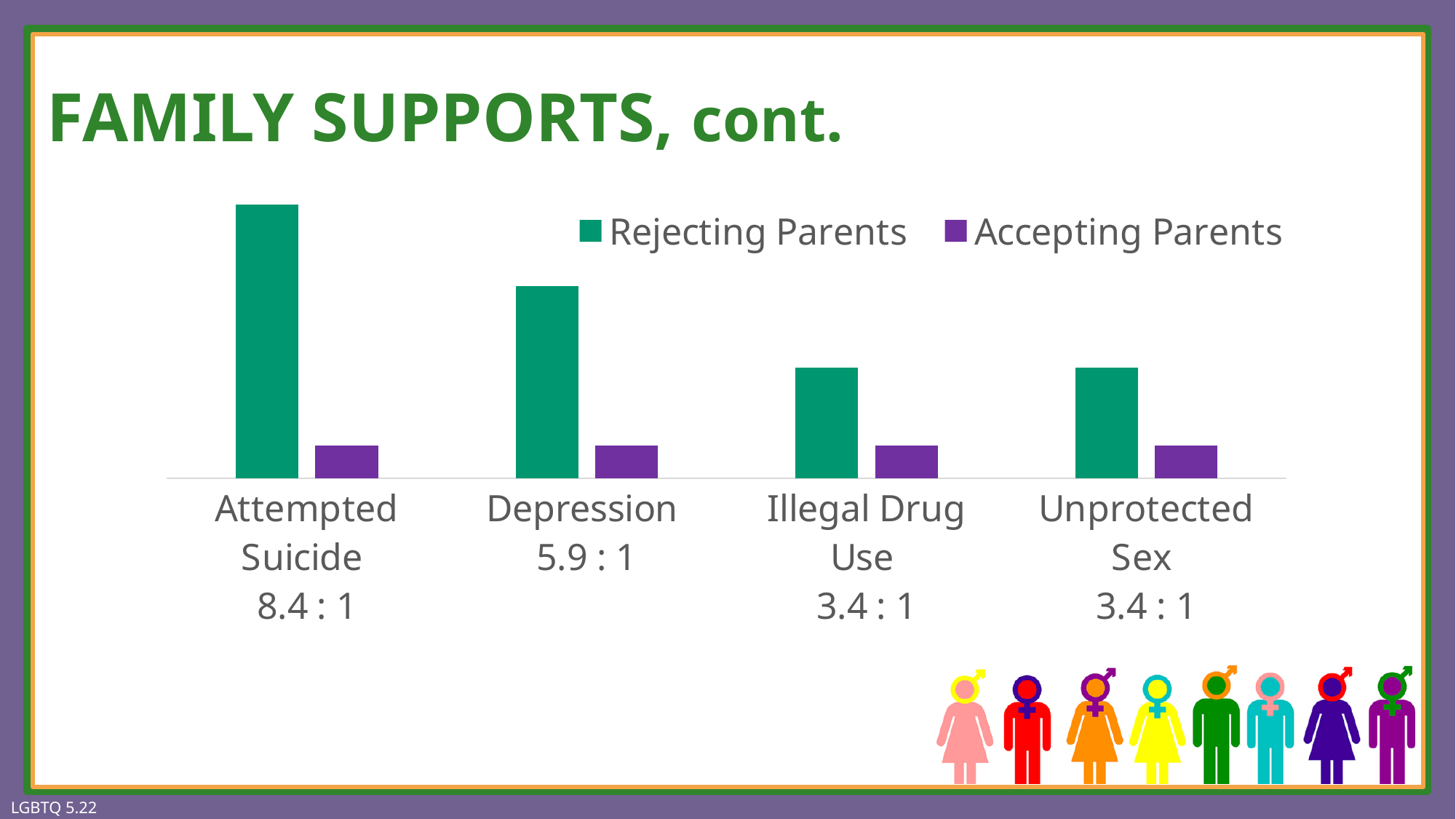
Which Rejecting Parents bar is taller: Attempted Suicide or Unprotected Sex? Attempted Suicide What ratio is printed under the Depression category label? 5.9 : 1 What ratio is printed under the Attempted Suicide category label? 8.4 : 1 What kind of chart is shown on the slide? bar chart For Attempted Suicide, which is larger: Rejecting Parents or Accepting Parents? Rejecting Parents What ratio is printed under the Illegal Drug Use category label? 3.4 : 1 Which colour represents the Accepting Parents series in the legend? purple Which Rejecting Parents bar is taller: Depression or Illegal Drug Use? Depression How many categories are shown on the x axis? 4 How many series does the legend list? 2 Which category has the highest Rejecting Parents bar? Attempted Suicide Do the Rejecting Parents bars rise or fall from left to right across the categories? fall